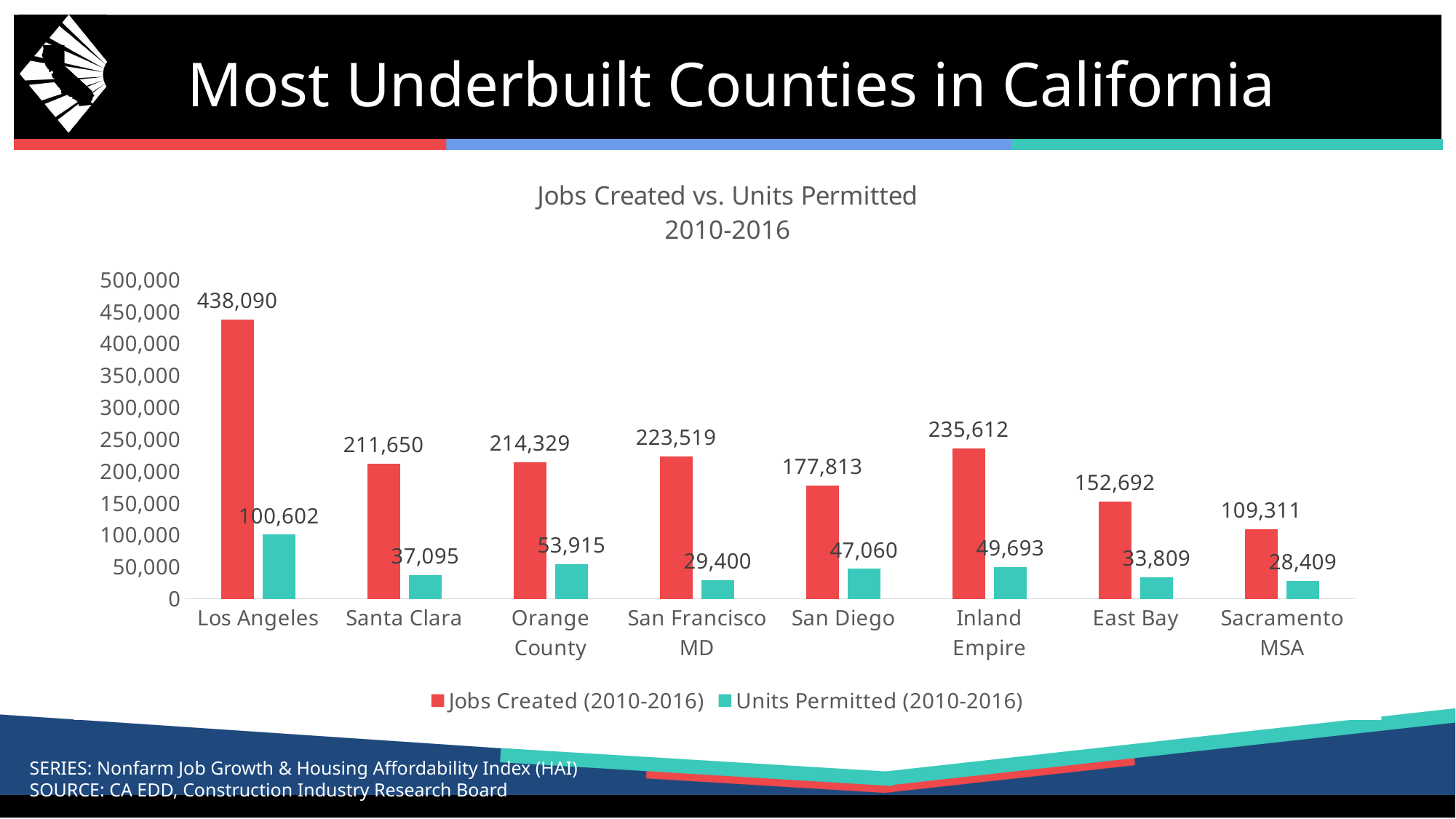
What is the value of Jobs Created (2010-2016) for Inland Empire? 235,612 Is the value of Jobs Created for San Diego greater or less than 200,000? less Which county has the highest value for Jobs Created (2010-2016)? Los Angeles What is the difference between Units Permitted for Orange County and Santa Clara? 16,820 How many counties or regions are shown on the x axis? 8 How many series does the legend list? 2 What is the value of Jobs Created (2010-2016) for Los Angeles? 438,090 What kind of chart is shown on the slide? Bar chart Which has more Jobs Created (2010-2016): Inland Empire or San Francisco MD? Inland Empire What is the value of Units Permitted (2010-2016) for San Francisco MD? 29,400 What is the difference between Jobs Created and Units Permitted for Los Angeles? 337,488 Which county has the lowest value for Units Permitted (2010-2016)? Sacramento MSA